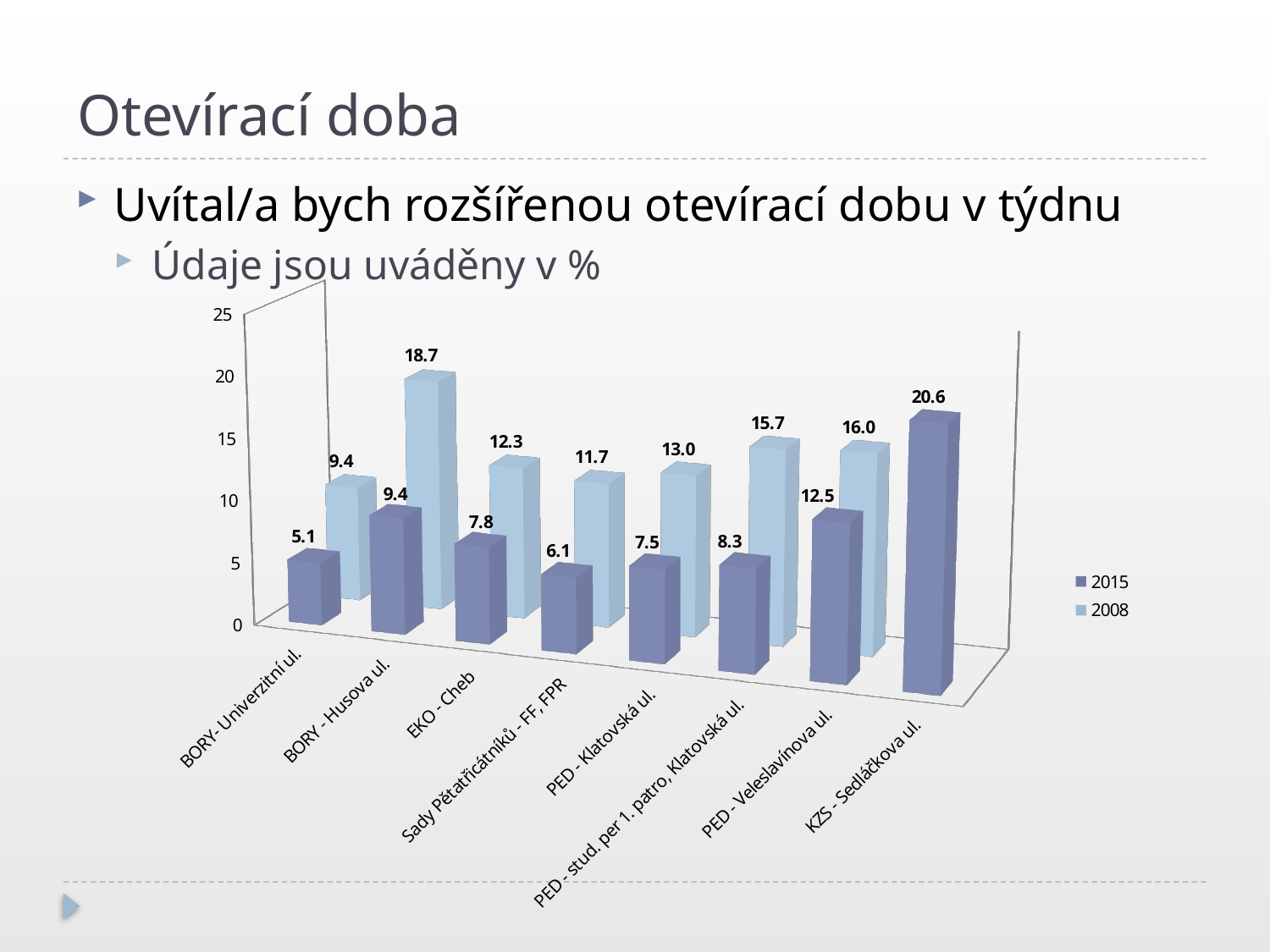
What kind of chart is shown on the slide? Bar chart How many series does the legend list? 2 What is the 2008 value for BORY - Husova ul.? 18.7 What is the difference between the 2008 and 2015 values for EKO - Cheb? 4.5 Which category has the highest 2008 value? BORY - Husova ul. How many categories are shown on the x axis? 8 Which category has the highest 2015 value? KZS - Sedláčkova ul. Which category has the lowest 2015 value? BORY - Univerzitní ul. What is the 2015 value for KZS - Sedláčkova ul.? 20.6 What is the 2008 value for PED - Veleslavínova ul.? 16.0 Which is larger for PED - Klatovská ul., the 2015 value or the 2008 value? 2008 What is the 2015 value for BORY - Univerzitní ul.? 5.1